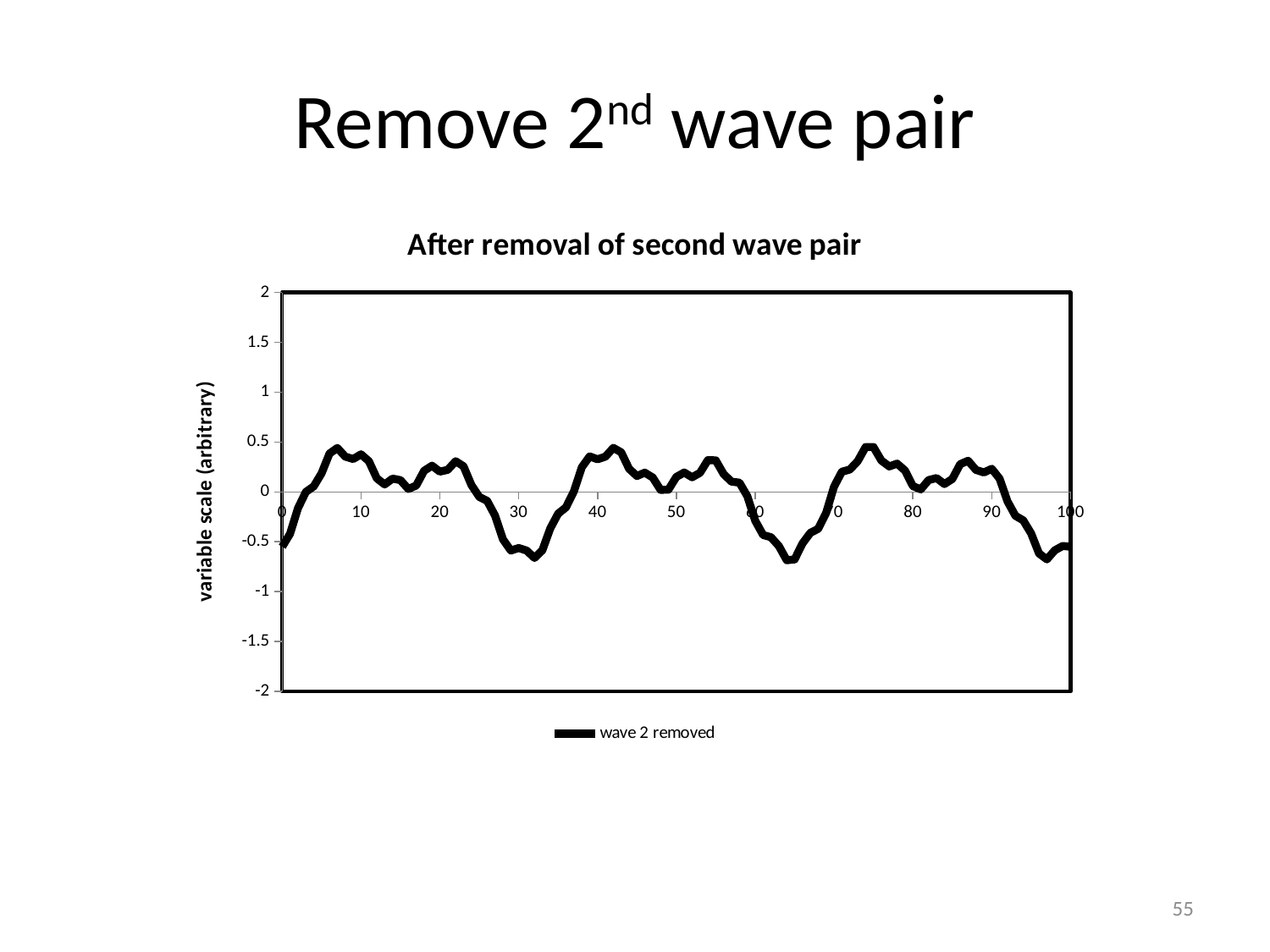
Does the 'wave 2 removed' series rise or fall between x = 90 and x = 97? fall Is the value of the 'wave 2 removed' series at x = 0 greater or less than 0? less Is the value of the 'wave 2 removed' series at x = 75 greater or less than 0? greater How many series does the legend list? 1 What is the name of the series shown in the legend? wave 2 removed What kind of chart is shown on the slide? line chart Is the value of the 'wave 2 removed' series at x = 40 greater or less than 1? less What is the title of the chart? After removal of second wave pair Does the 'wave 2 removed' series rise or fall between x = 0 and x = 7? rise